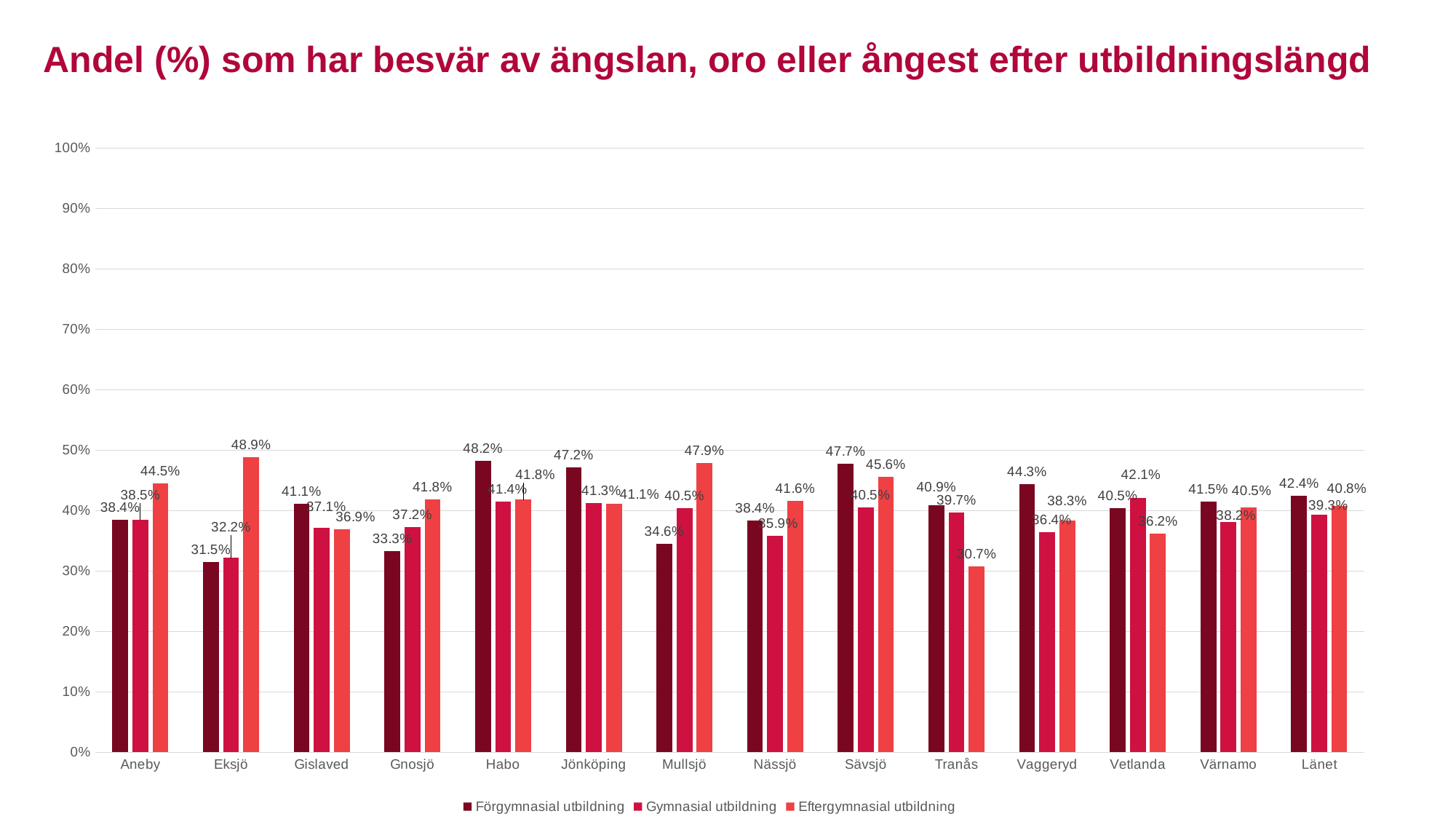
What is the value for Gymnasial utbildning in Länet? 39.3% What is the difference between Förgymnasial utbildning and Eftergymnasial utbildning in Tranås? 10.2 percentage points How many municipalities/categories are shown on the x axis? 14 How many series does the legend list? 3 What kind of chart is shown on the slide? Bar chart Which municipality has the lowest value for Förgymnasial utbildning? Eksjö What is the difference between Eftergymnasial utbildning and Förgymnasial utbildning in Eksjö? 17.4 percentage points What is the value for Förgymnasial utbildning in Habo? 48.2% Which municipality has the highest value for Eftergymnasial utbildning? Eksjö Which municipality has the lowest value for Eftergymnasial utbildning? Tranås What is the value for Eftergymnasial utbildning in Eksjö? 48.9% In Mullsjö, which is larger: Förgymnasial utbildning or Eftergymnasial utbildning? Eftergymnasial utbildning